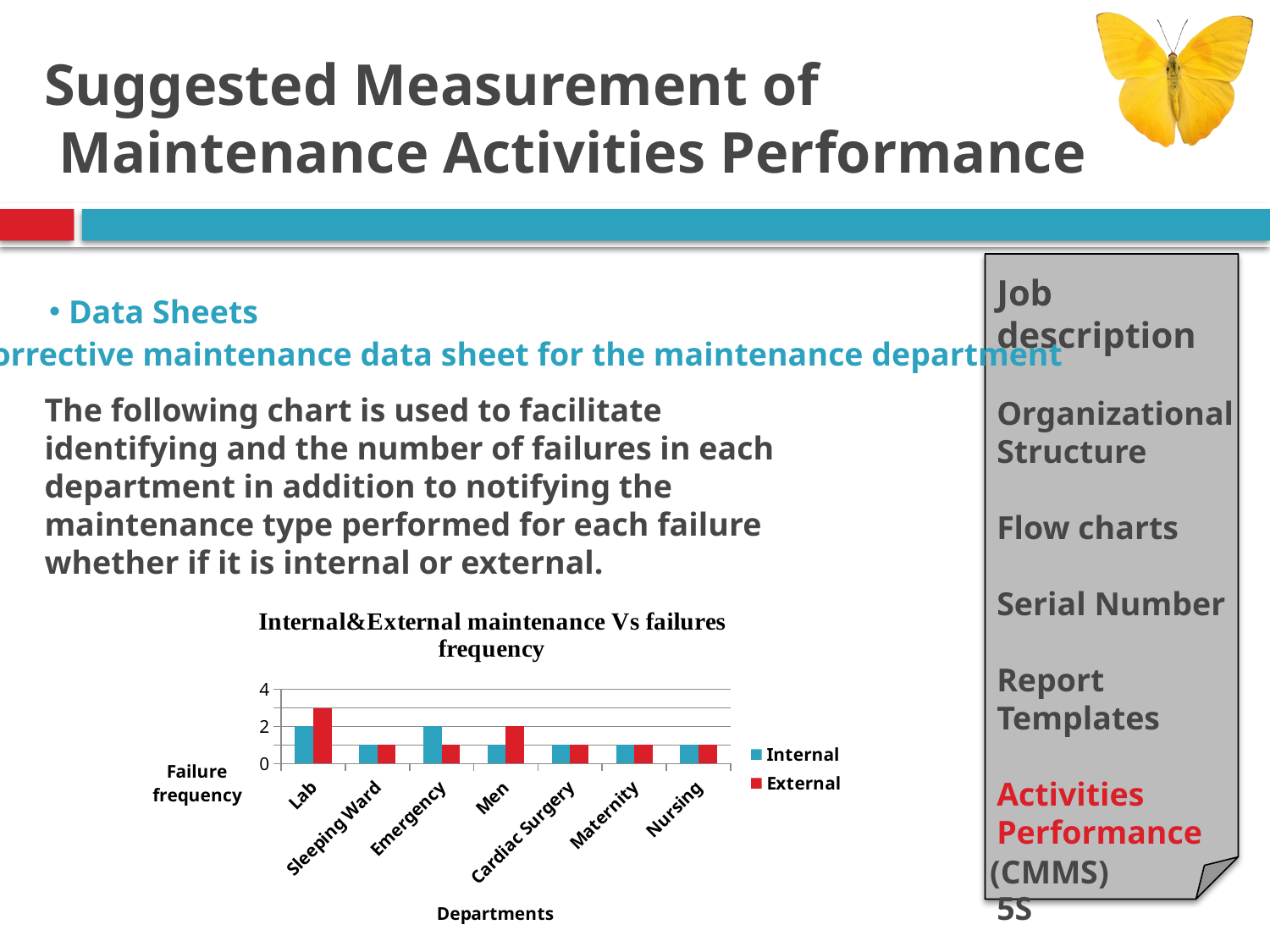
What is the Internal value for Lab? 2 Is the External value for Lab greater or less than 2? greater For Emergency, which is larger, the Internal or the External value? Internal How many series does the chart legend list? 2 What is the Internal value for Emergency? 2 Which department has the highest External value? Lab Is the Internal value for Sleeping Ward greater or less than 2? less What is the External value for Men? 2 For Lab, which is larger, the Internal or the External value? External What is the title of the chart? Internal&External maintenance Vs failures frequency How many departments are shown on the x axis of the chart? 7 What type of chart is shown on the slide? bar chart